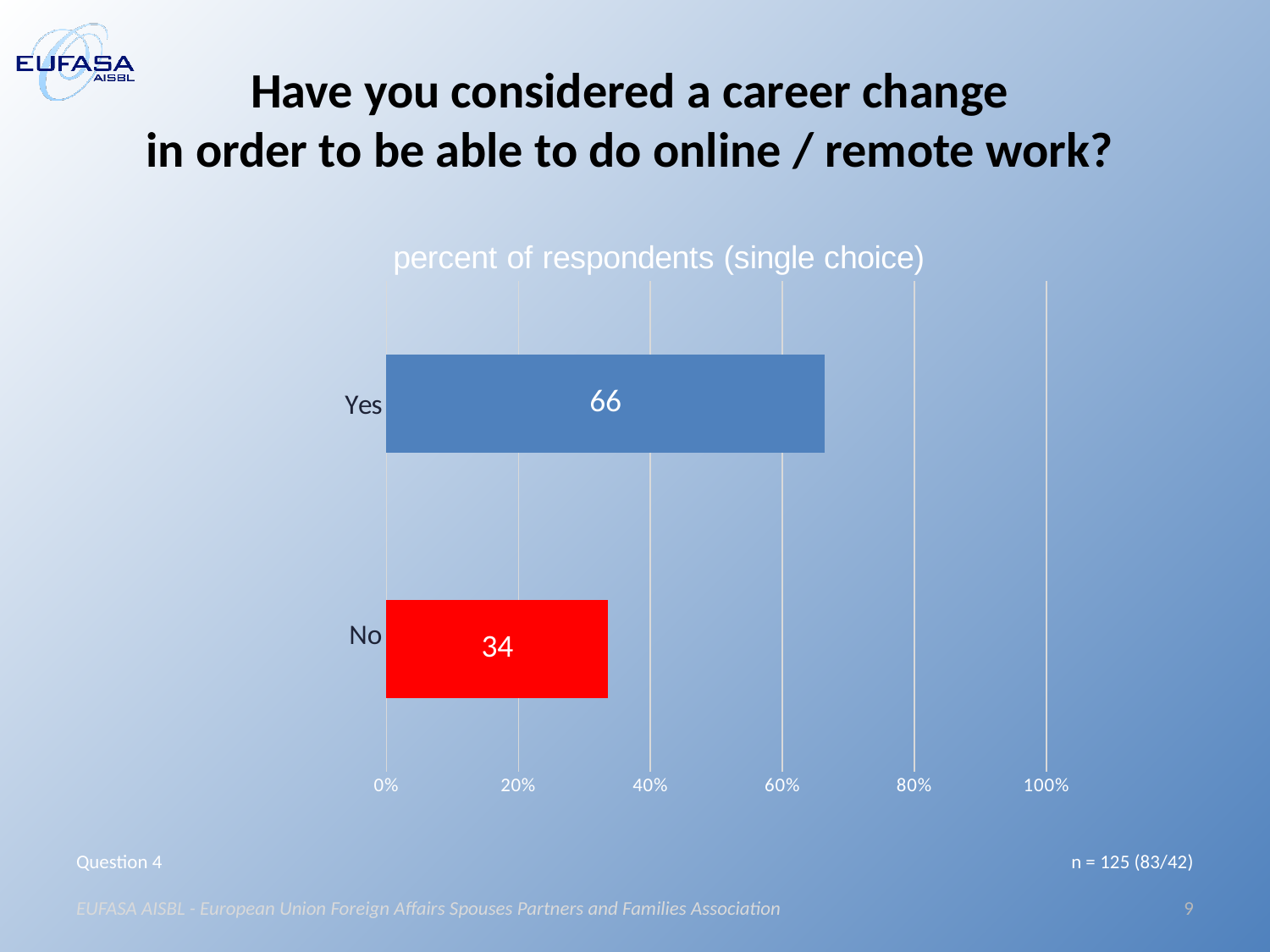
What is the title of the chart? percent of respondents (single choice) Is the value for No greater or less than 40%? less What colour is the bar for No? red Which is larger, the value for Yes or the value for No? Yes Is the value for Yes greater or less than 60%? greater Which category has the highest value? Yes How many categories are shown in the chart? 2 What kind of chart is shown on the slide? bar chart What is the value for Yes? 66 What is the value for No? 34 Which category has the lowest value? No What is the difference between the values for Yes and No? 32